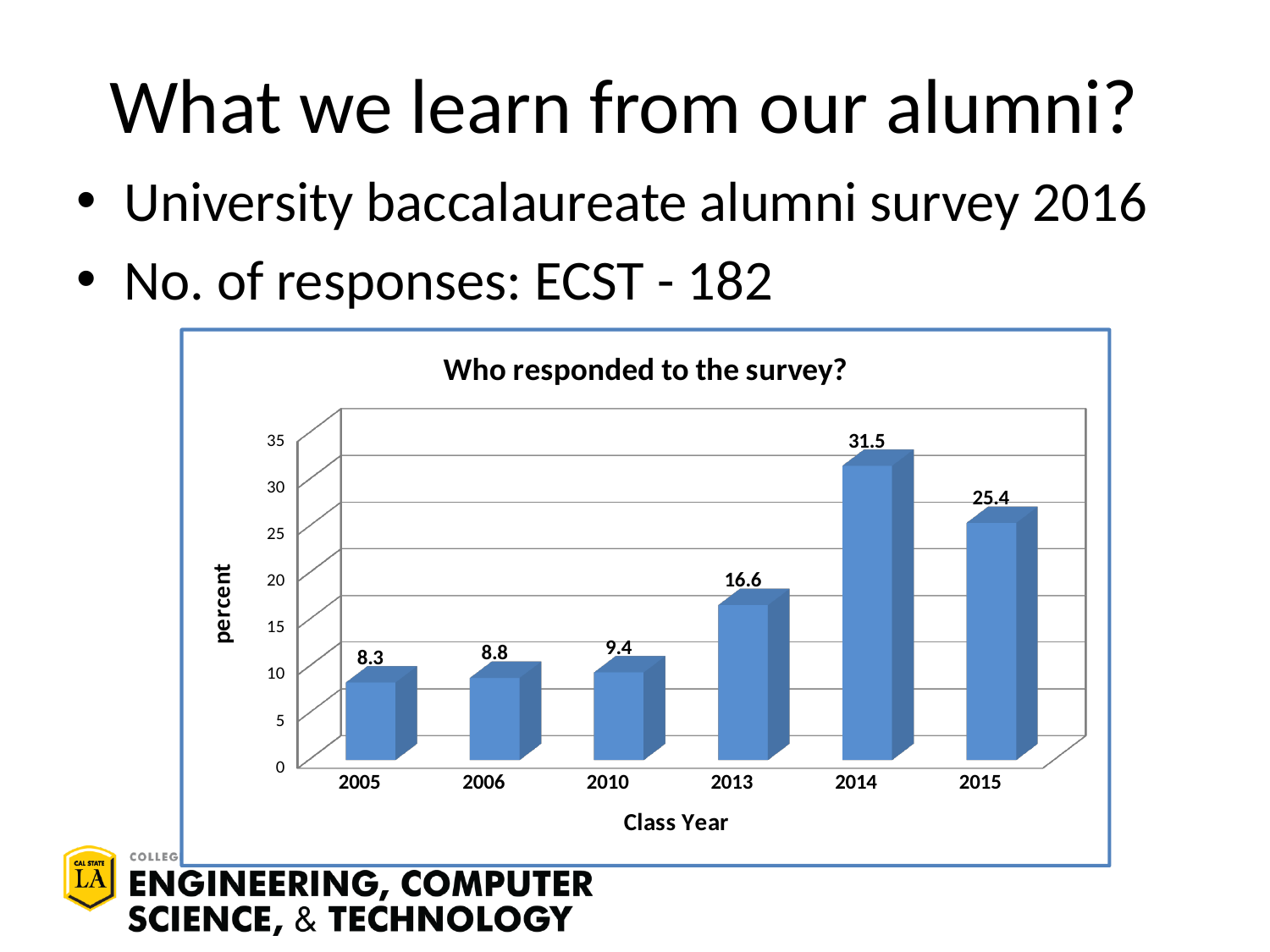
Which class year has the highest value? 2014 What is the title of the chart? Who responded to the survey? What is the value for class year 2014? 31.5 What is the value for class year 2005? 8.3 What is the value for class year 2013? 16.6 Which is larger, the value for 2006 or the value for 2010? 2010 What is the difference between the values for 2014 and 2015? 6.1 How many class years are shown on the x axis? 6 What is the difference between the values for 2013 and 2010? 7.2 Is the value for 2015 greater or less than 20? greater What kind of chart is this? bar chart Which class year has the lowest value? 2005